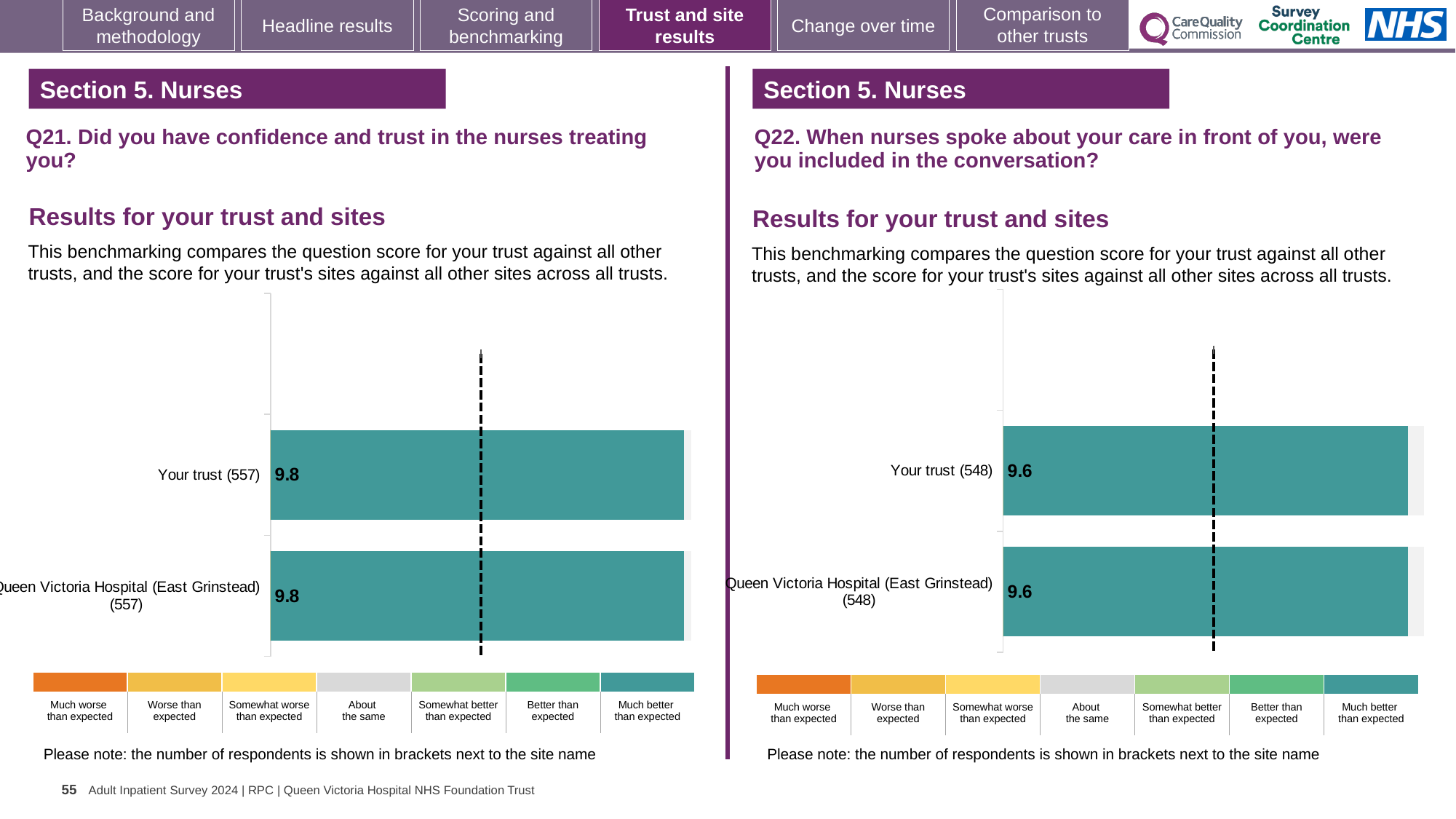
What kind of chart is used for the Q22 results (right)? Bar chart On the Q21 chart (left), how many respondents are shown in brackets for Your trust? 557 On the Q22 chart (right), which benchmark category does the colour of the bars correspond to in the key below the chart? Much better than expected How many bars are plotted on the Q21 chart (left)? 2 On the Q22 chart (right), what is the score for Your trust (548)? 9.6 How many bars are plotted on the Q22 chart (right)? 2 On the Q22 chart (right), what is the difference between the score for Your trust and the score for Queen Victoria Hospital (East Grinstead)? 0.0 On the Q21 chart (left), what is the score for Your trust (557)? 9.8 On the Q21 chart (left), what is the score for Queen Victoria Hospital (East Grinstead) (557)? 9.8 On the Q22 chart (right), what is the score for Queen Victoria Hospital (East Grinstead) (548)? 9.6 On the Q21 chart (left), what is the difference between the score for Your trust and the score for Queen Victoria Hospital (East Grinstead)? 0.0 Which is larger: the Your trust score on the Q21 chart (left) or the Your trust score on the Q22 chart (right)? Q21 (9.8)